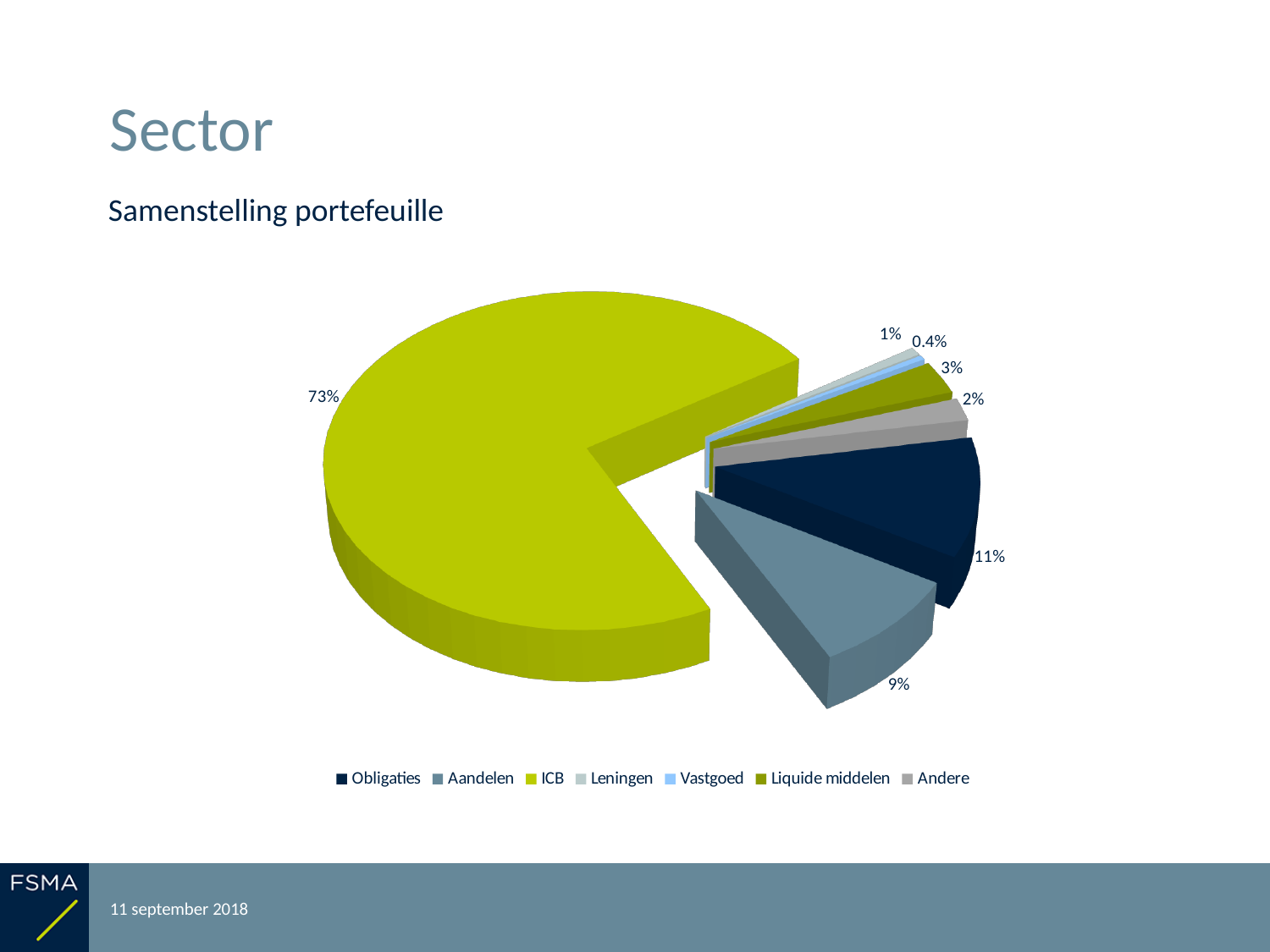
Which category has the smallest slice of the pie? Vastgoed What percentage is shown for Liquide middelen? 3% What is the value for Vastgoed? 0.4% What is the title of the chart? Samenstelling portefeuille What type of chart is shown on the slide? Pie chart What percentage does Obligaties represent in the pie chart? 11% Which is larger, Liquide middelen or Andere? Liquide middelen How many categories does the legend list? 7 What is the difference in percentage points between Obligaties and Aandelen? 2 Which category has the largest slice of the pie? ICB What is the value shown for Aandelen? 9% What share of the portfolio is ICB? 73%